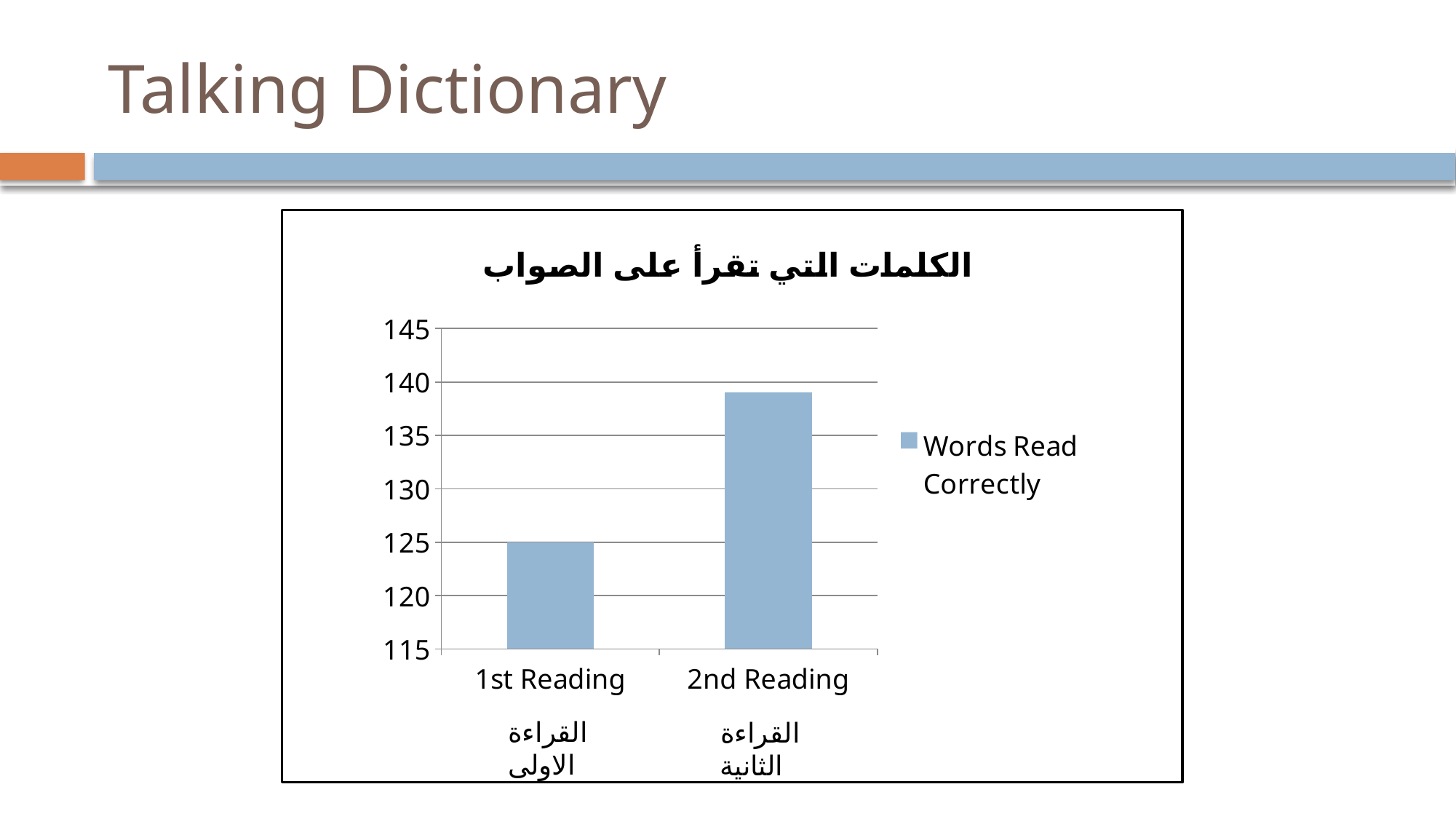
Which category has the highest value? 2nd Reading Is the value for 2nd Reading greater or less than 140? less How many series does the chart's legend list? 1 Which category has the lowest value? 1st Reading Do the values rise or fall from 1st Reading to 2nd Reading? rise What kind of chart is shown on the slide? bar chart How many categories are plotted on the x axis of the chart? 2 What is the highest tick value shown on the chart's vertical axis? 145 What is the name of the series listed in the chart's legend? Words Read Correctly Is the value for 2nd Reading greater or less than 135? greater Which is larger, the value for 1st Reading or the value for 2nd Reading? 2nd Reading What is the value for 1st Reading? 125